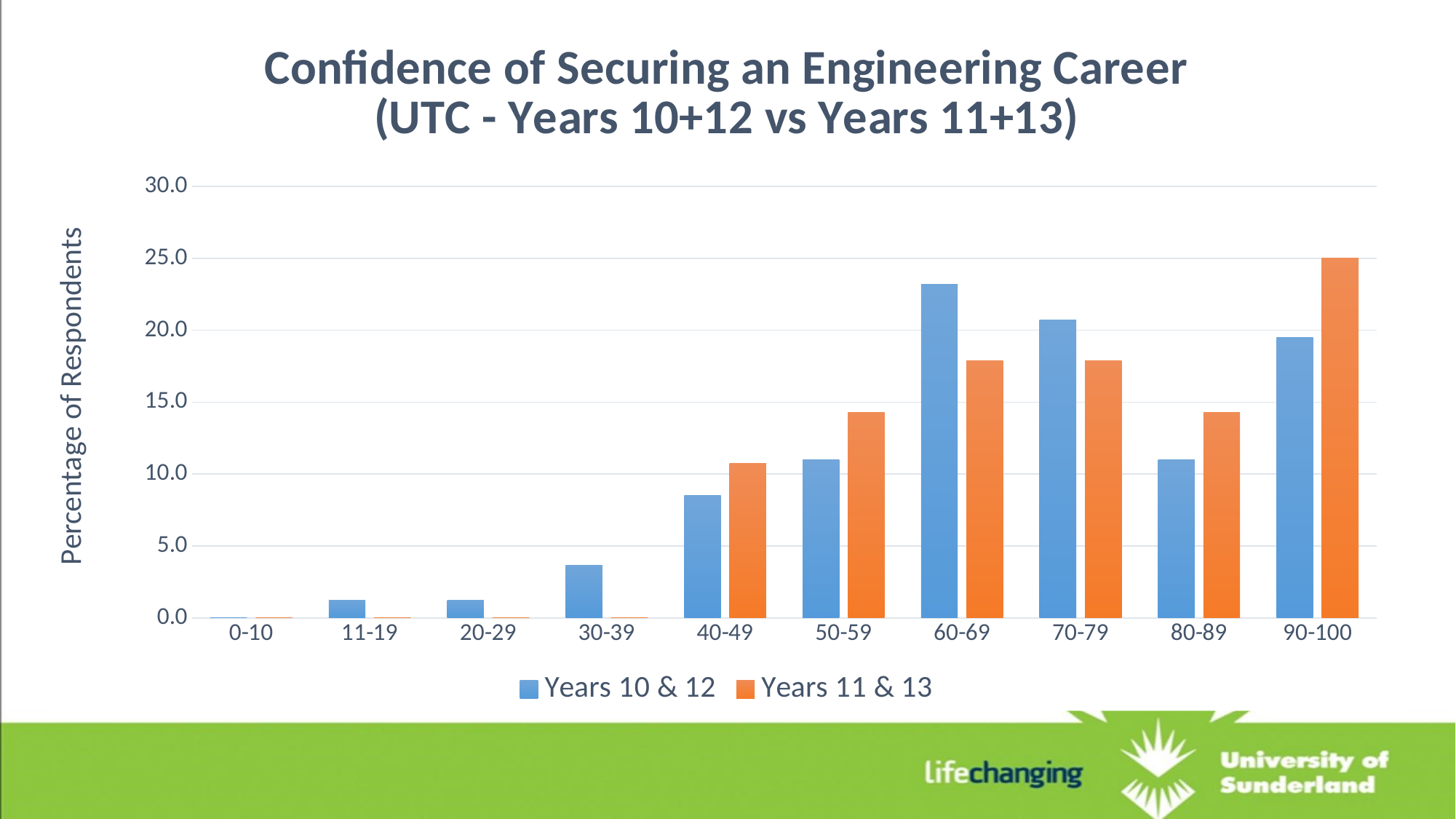
For which category is the Years 10 & 12 value highest? 60-69 How many series does the legend list? 2 How many confidence categories are shown along the x axis? 10 What kind of chart is shown on the slide? Bar chart Is the Years 10 & 12 value for 30-39 greater or less than 5? less What is the label of the y axis? Percentage of Respondents In the 60-69 category, which series has the larger value, Years 10 & 12 or Years 11 & 13? Years 10 & 12 Is the Years 10 & 12 value for 40-49 greater or less than 10? less Is the Years 11 & 13 value for 90-100 greater or less than 20? greater For which category is the Years 11 & 13 value highest? 90-100 In the 90-100 category, which series has the larger value, Years 10 & 12 or Years 11 & 13? Years 11 & 13